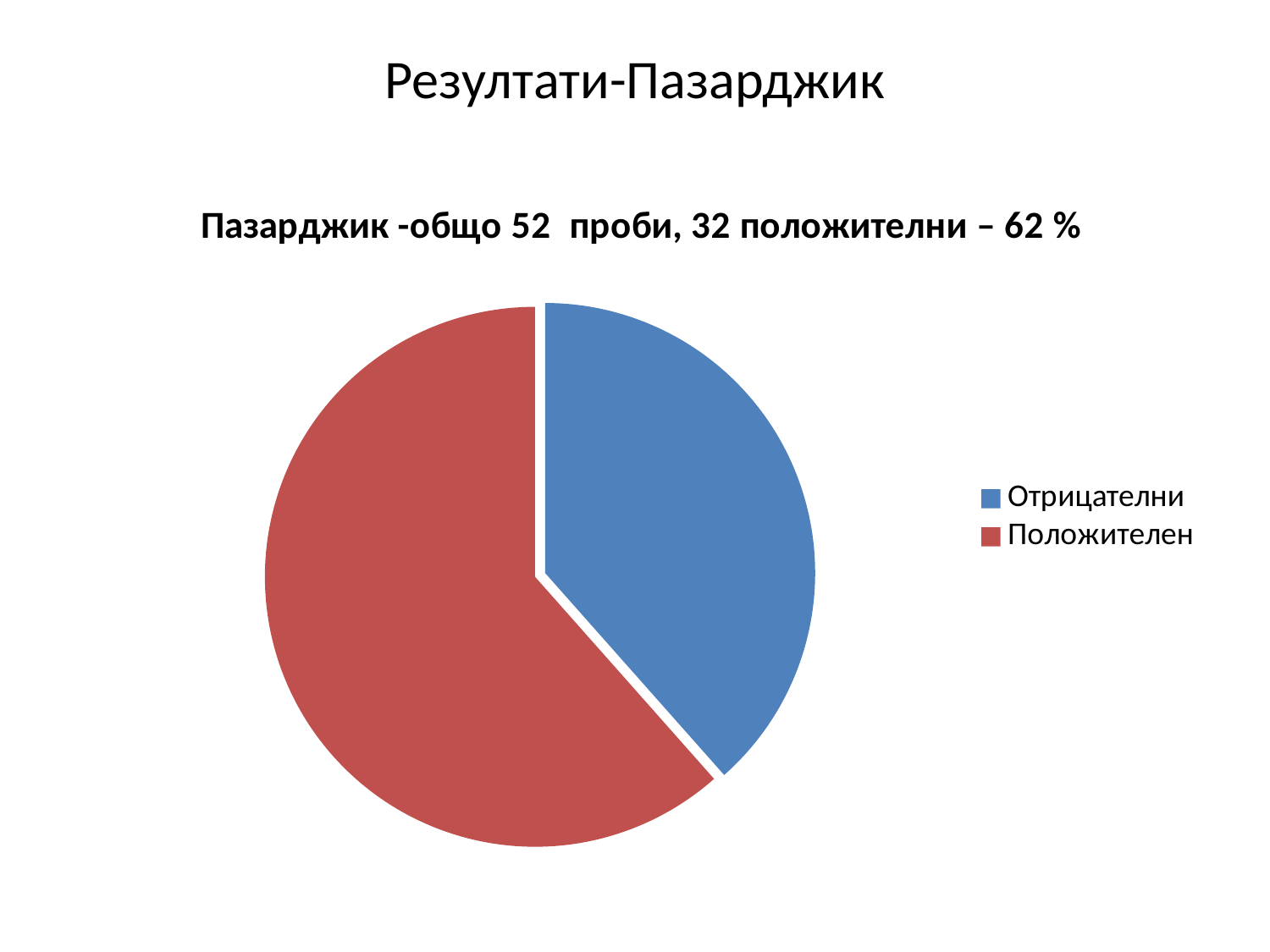
How many slices does the pie chart have? 2 What kind of chart is shown on the slide? pie chart According to the chart title, how many samples (проби) were tested in total in Пазарджик? 52 What colour is the Отрицателни slice in the pie chart? blue How many entries does the legend of the pie chart list? 2 Which slice is larger, Отрицателни or Положителен? Положителен Which category has the largest slice in the pie chart? Положителен According to the chart title, how many samples were positive (положителни)? 32 Does the Положителен slice cover more or less than half of the pie? more Which category has the smallest slice in the pie chart? Отрицателни What is the title of the pie chart? Пазарджик -общо 52 проби, 32 положителни – 62 % According to the chart title, what share of the samples were positive (положителни)? 62 %